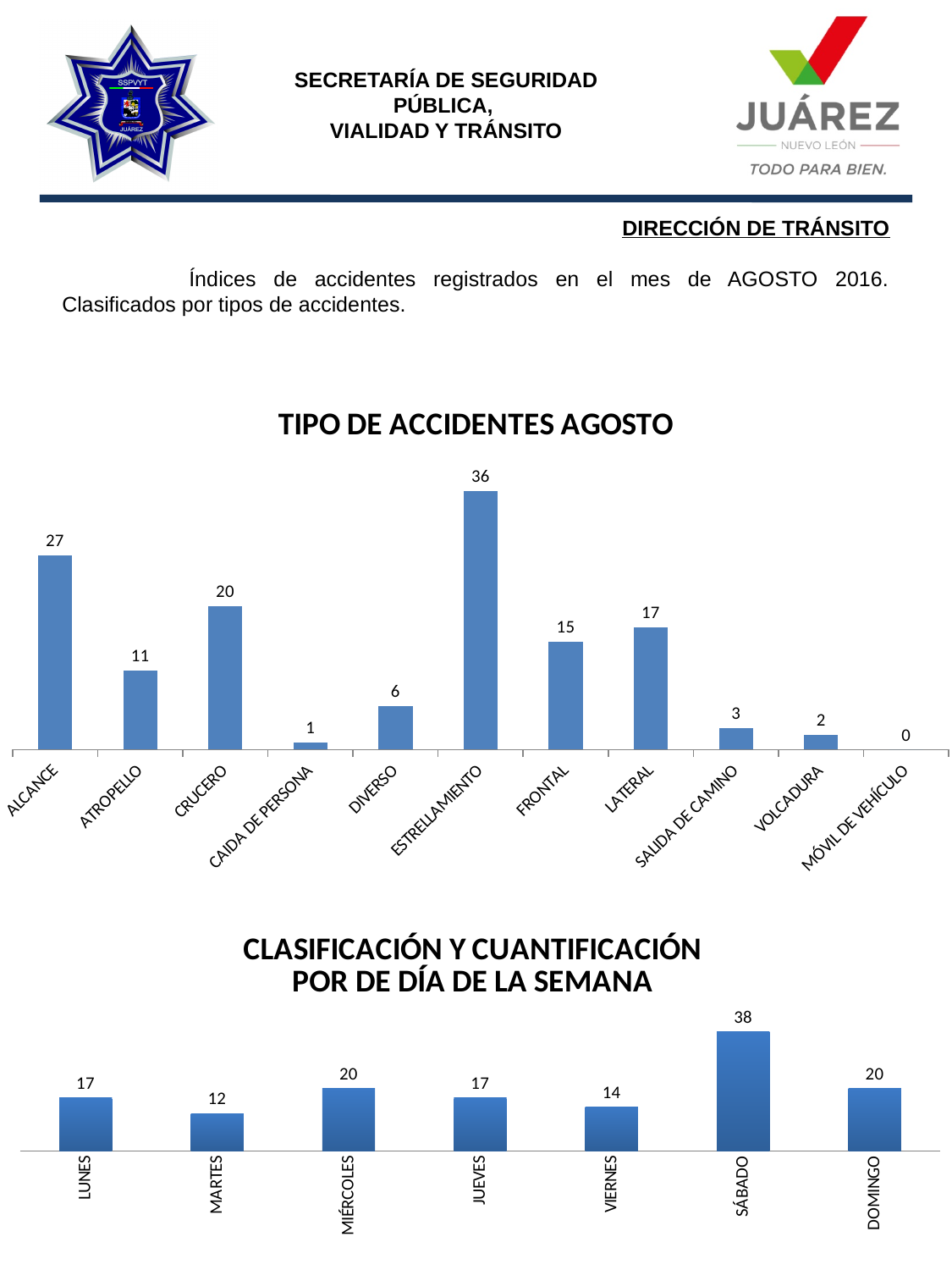
In the 'TIPO DE ACCIDENTES AGOSTO' chart, which category has the lowest value? MÓVIL DE VEHÍCULO In the 'CLASIFICACIÓN Y CUANTIFICACIÓN POR DE DÍA DE LA SEMANA' chart, what is the value for SÁBADO? 38 How many categories are shown in the 'TIPO DE ACCIDENTES AGOSTO' chart? 11 In the 'TIPO DE ACCIDENTES AGOSTO' chart, what is the difference between ALCANCE and CRUCERO? 7 What kind of chart is 'TIPO DE ACCIDENTES AGOSTO'? Bar chart In the 'CLASIFICACIÓN Y CUANTIFICACIÓN POR DE DÍA DE LA SEMANA' chart, which day has the lowest value? MARTES In the 'CLASIFICACIÓN Y CUANTIFICACIÓN POR DE DÍA DE LA SEMANA' chart, what is the difference between SÁBADO and VIERNES? 24 In the 'TIPO DE ACCIDENTES AGOSTO' chart, which is larger, FRONTAL or LATERAL? LATERAL How many days are shown in the 'CLASIFICACIÓN Y CUANTIFICACIÓN POR DE DÍA DE LA SEMANA' chart? 7 In the 'TIPO DE ACCIDENTES AGOSTO' chart, what is the value for ESTRELLAMIENTO? 36 In the 'TIPO DE ACCIDENTES AGOSTO' chart, what is the value for ATROPELLO? 11 In the 'TIPO DE ACCIDENTES AGOSTO' chart, which category has the highest value? ESTRELLAMIENTO